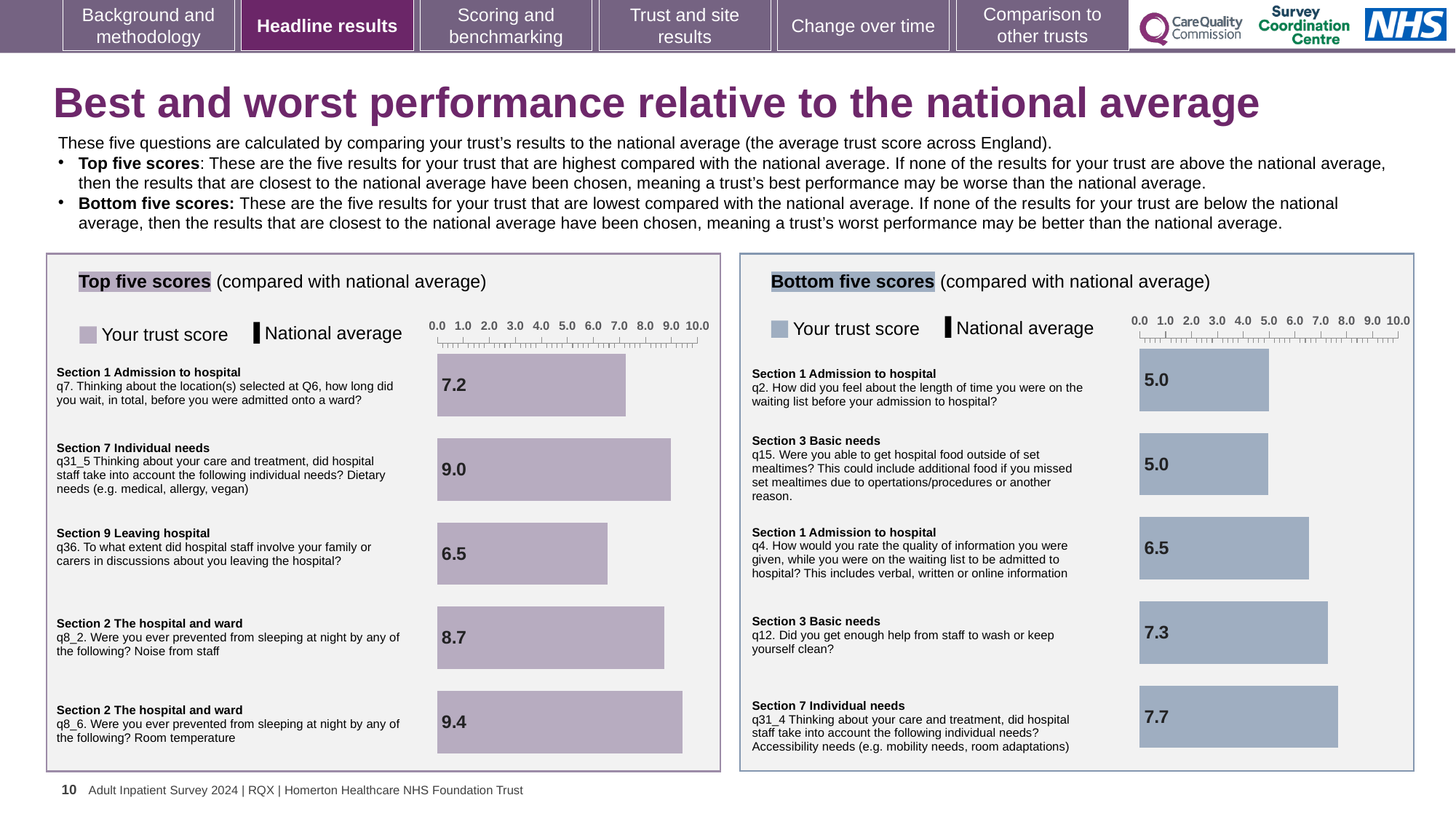
In the Bottom five scores chart, which question has the highest trust score? q31_4 Thinking about your care and treatment, did hospital staff take into account the following individual needs? Accessibility needs In the Top five scores chart, which question has the lowest trust score? q36. To what extent did hospital staff involve your family or carers in discussions about you leaving the hospital? In the Bottom five scores chart, what is the trust score for q4 (quality of information given while on the waiting list)? 6.5 How many entries does the legend of the Bottom five scores chart list? 2 In the Top five scores chart, what is the difference between the trust scores for q8_6 (room temperature) and q8_2 (noise from staff)? 0.7 In the Bottom five scores chart, what is the difference between the trust scores for q31_4 (accessibility needs) and q2 (length of time on the waiting list)? 2.7 In the Bottom five scores chart, what is the trust score for q12 (enough help from staff to wash or keep yourself clean)? 7.3 In the Top five scores chart, what is the trust score for q7 (how long did you wait before being admitted onto a ward)? 7.2 In the Top five scores chart, which question has the highest trust score? q8_6. Were you ever prevented from sleeping at night by any of the following? Room temperature What type of chart is used in the Top five scores panel? Bar chart In the Top five scores chart, how many questions are plotted? 5 In the Bottom five scores chart, is the trust score for q2 (length of time on the waiting list) greater or less than 6.0? less